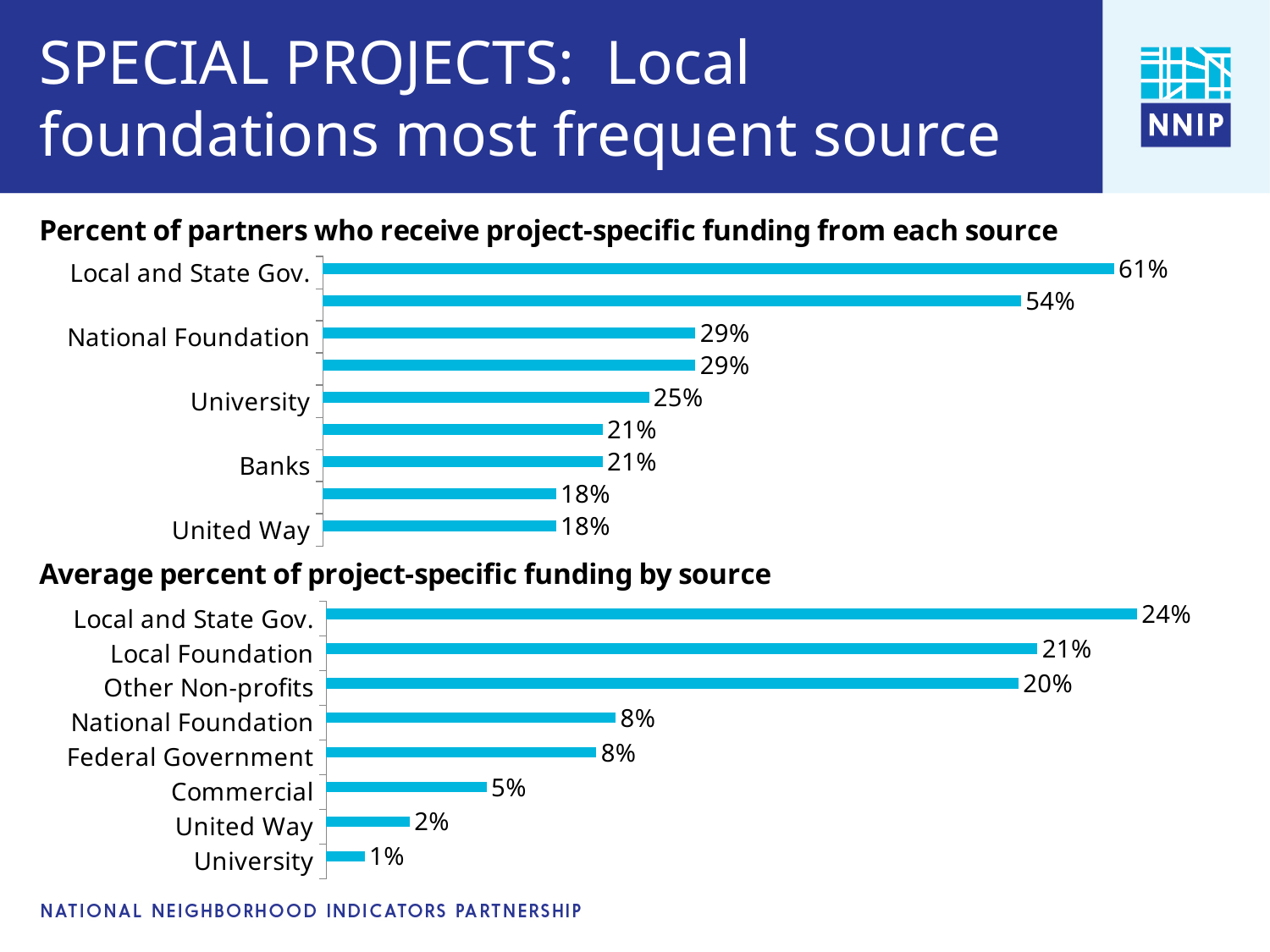
In the top chart, 'Percent of partners who receive project-specific funding from each source', what is the value for University? 25% In the bottom chart, 'Average percent of project-specific funding by source', what is the difference between Local and State Gov. and Local Foundation? 3 percentage points In the top chart, 'Percent of partners who receive project-specific funding from each source', what is the value for Local and State Gov.? 61% What type of chart is the bottom chart, 'Average percent of project-specific funding by source'? Bar chart In the bottom chart, 'Average percent of project-specific funding by source', which source has the lowest value? University In the bottom chart, 'Average percent of project-specific funding by source', what is the value for Other Non-profits? 20% In the bottom chart, 'Average percent of project-specific funding by source', which is larger: Local Foundation or Federal Government? Local Foundation In the bottom chart, 'Average percent of project-specific funding by source', how many sources are shown? 8 In the top chart, 'Percent of partners who receive project-specific funding from each source', how many percentage points higher is Local and State Gov. than National Foundation? 32 percentage points In the top chart, 'Percent of partners who receive project-specific funding from each source', what is the value for Banks? 21% In the top chart, 'Percent of partners who receive project-specific funding from each source', which labeled source has the highest value? Local and State Gov. In the bottom chart, 'Average percent of project-specific funding by source', what is the value for Commercial? 5%